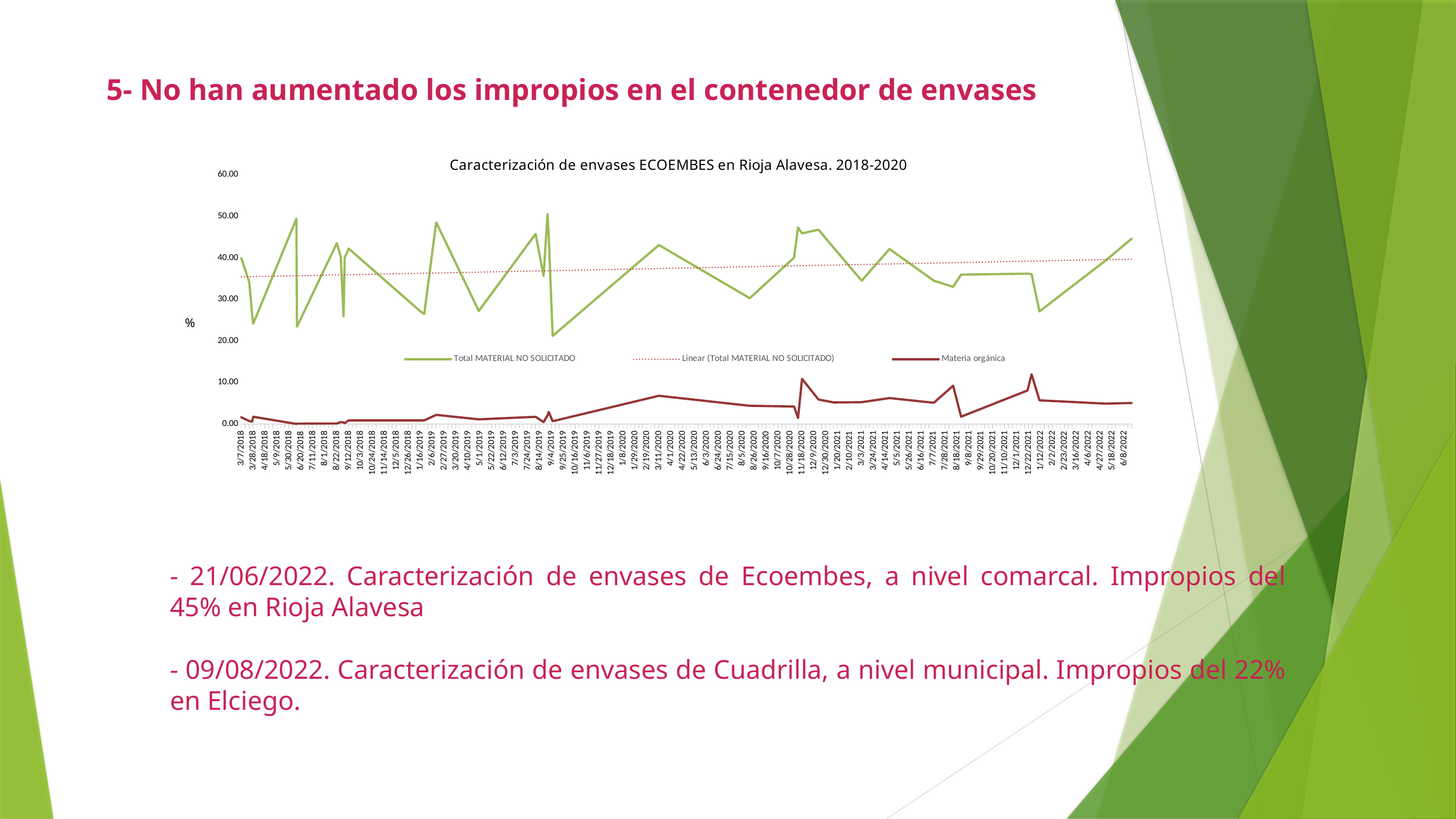
What kind of chart is shown on the slide? Line chart Does the Linear (Total MATERIAL NO SOLICITADO) trendline rise or fall from left to right? Rises Is the value of Total MATERIAL NO SOLICITADO on 1/12/2022 greater or less than 30? less What is the highest value shown on the vertical axis of the chart? 60.00 Is the value of Materia orgánica on 11/18/2020 greater or less than 5? greater What is the title of the chart? Caracterización de envases ECOEMBES en Rioja Alavesa. 2018-2020 Which series has higher values throughout the chart, Total MATERIAL NO SOLICITADO or Materia orgánica? Total MATERIAL NO SOLICITADO How many entries does the chart legend list? 3 What unit is shown on the vertical axis label of the chart? % Is the value of Materia orgánica on 3/7/2018 greater or less than 10? less